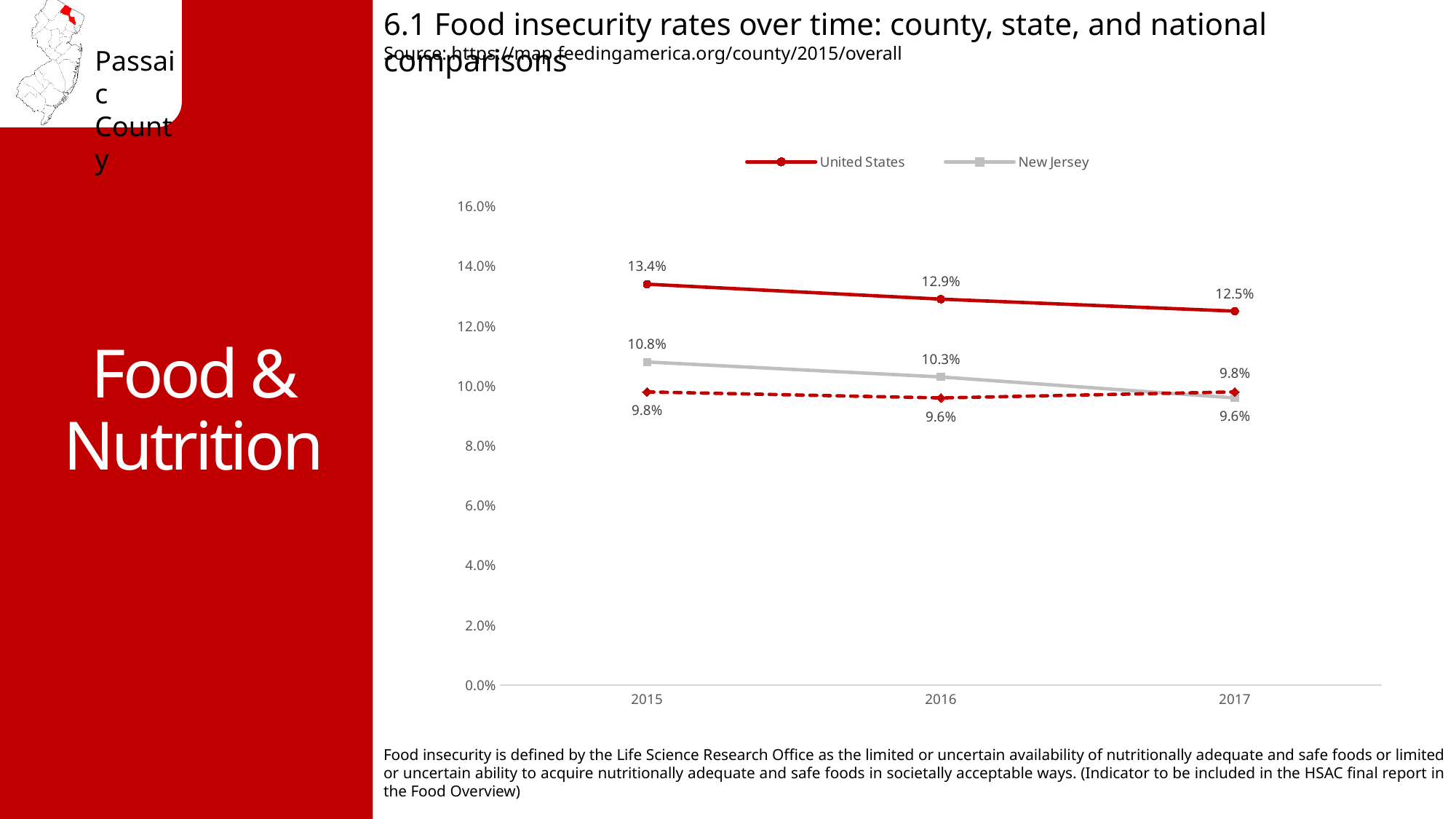
What is the food insecurity rate for New Jersey in 2017? 9.6% In which year is the New Jersey food insecurity rate lowest? 2017 What is the food insecurity rate for the United States in 2017? 12.5% Does the United States food insecurity rate rise or fall from 2015 to 2017? Fall By how much did the United States food insecurity rate fall from 2015 to 2017? 0.9% What is the difference between the United States and New Jersey food insecurity rates in 2016? 2.6% How many series does the legend list? 2 What is the food insecurity rate for the United States in 2015? 13.4% What is the food insecurity rate for New Jersey in 2016? 10.3% Which has the higher food insecurity rate in 2015, the United States or New Jersey? United States How many years are shown on the x axis? 3 In which year is the United States food insecurity rate highest? 2015